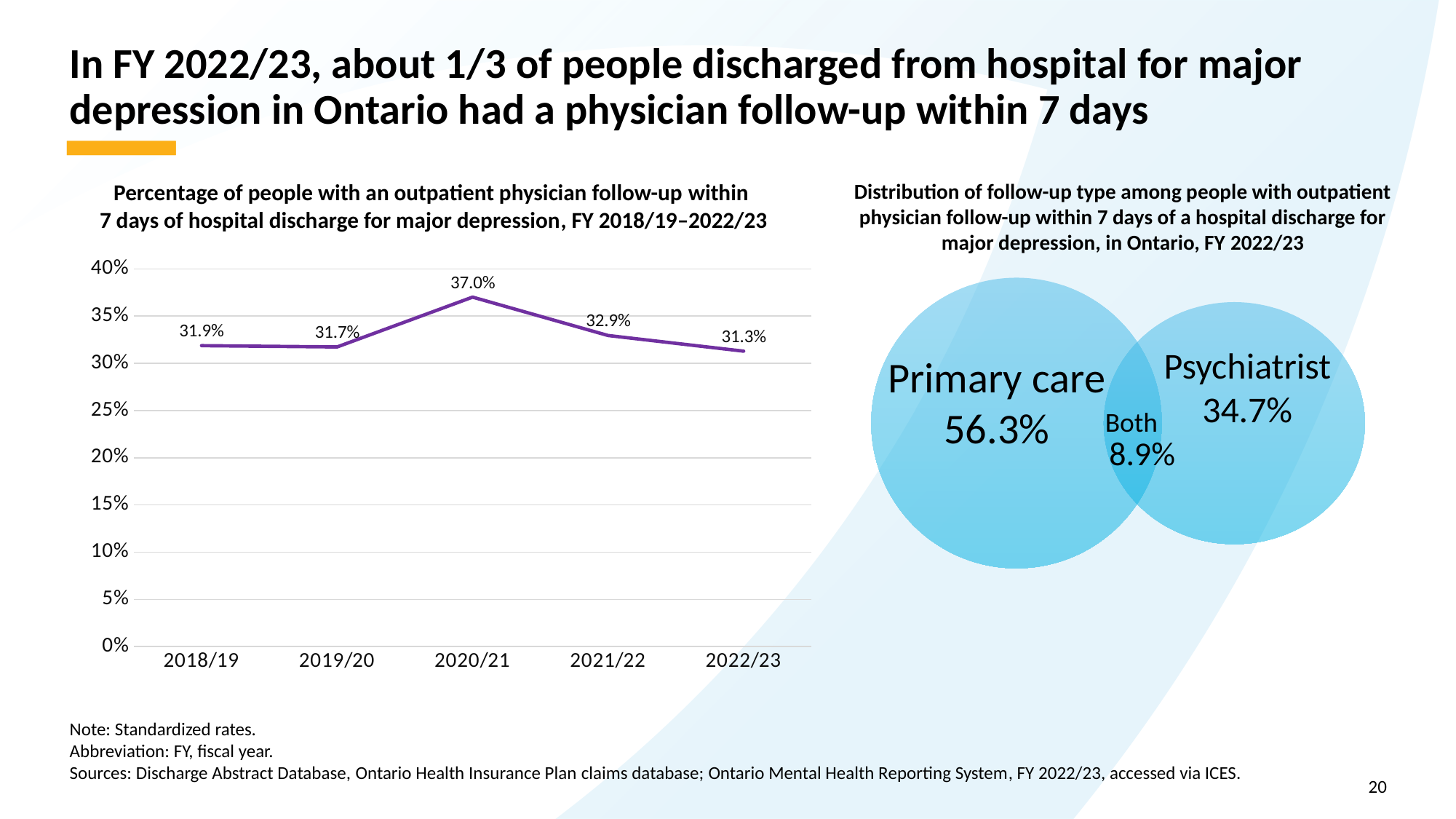
In the diagram on the right showing the distribution of follow-up type, what percentage had both primary care and psychiatrist follow-up? 8.9% What kind of chart is shown on the left of the slide? Line chart In the line chart on the left, what is the difference between the FY 2020/21 value and the FY 2022/23 value? 5.7 percentage points In the line chart on the left, what is the value for FY 2022/23? 31.3% In the line chart on the left, what is the percentage of people with an outpatient physician follow-up within 7 days in FY 2020/21? 37.0% In the line chart on the left, which fiscal year has the highest percentage? 2020/21 In the line chart on the left, which is larger, the value for FY 2018/19 or the value for FY 2021/22? 2021/22 In the line chart on the left, does the percentage rise or fall from FY 2020/21 to FY 2022/23? Fall In the diagram on the right showing the distribution of follow-up type, what percentage had a primary care follow-up? 56.3% In the line chart on the left, which fiscal year has the lowest percentage? 2022/23 In the line chart on the left, is the value for FY 2020/21 greater or less than 35%? greater How many fiscal years are plotted in the line chart on the left? 5